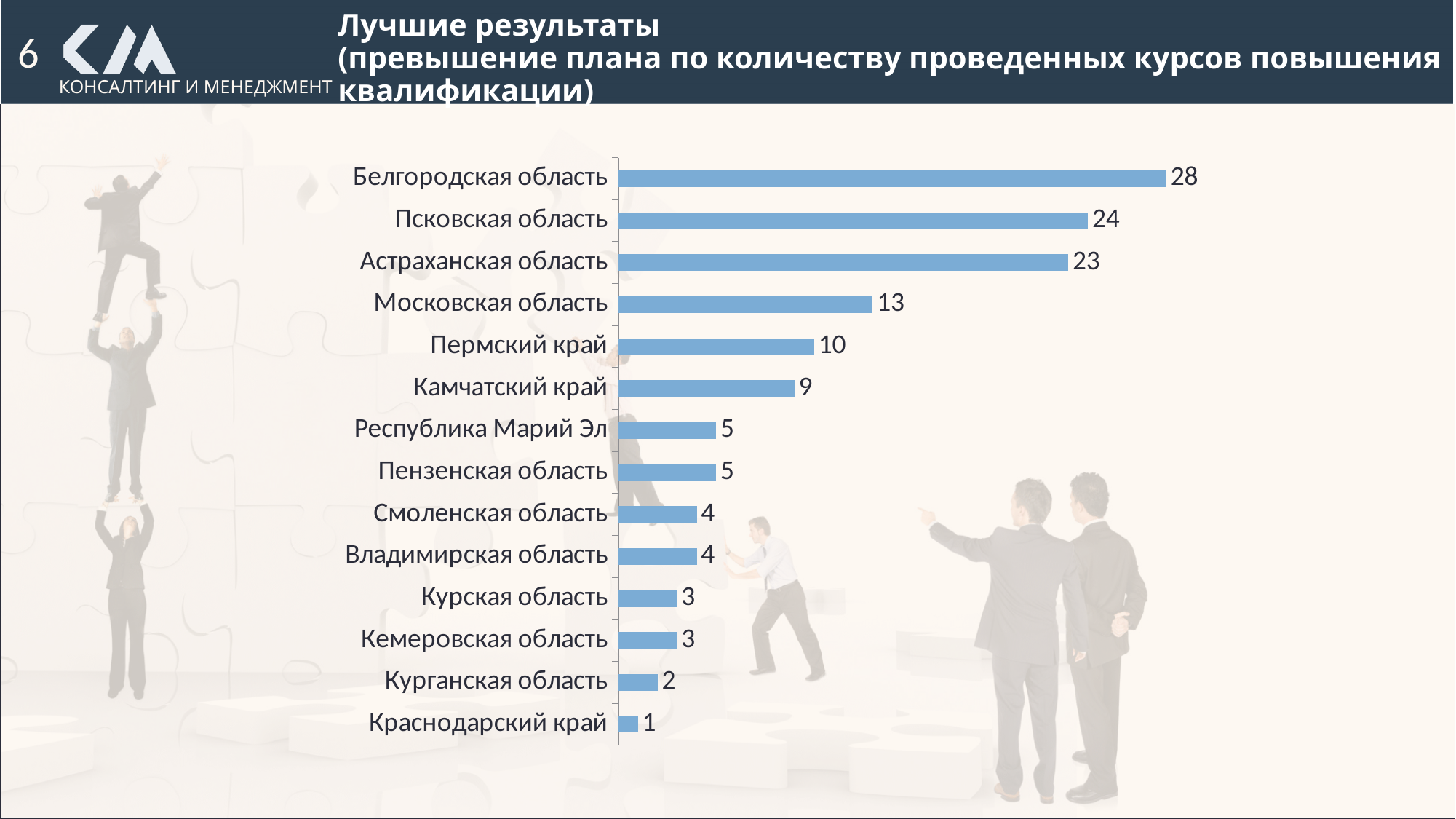
What is the value for Камчатский край? 9 Which is larger, the value for Московская область or the value for Камчатский край? Московская область Which category has the lowest value? Краснодарский край What is the difference between the values for Белгородская область and Пермский край? 18 What is the value for Московская область? 13 Which category has the highest value? Белгородская область What is the value for Курганская область? 2 What is the value for Белгородская область? 28 What is the difference between the values for Псковская область and Астраханская область? 1 How many categories are shown in the chart? 14 What colour are the bars in the chart? Blue What kind of chart is shown on the slide? Bar chart